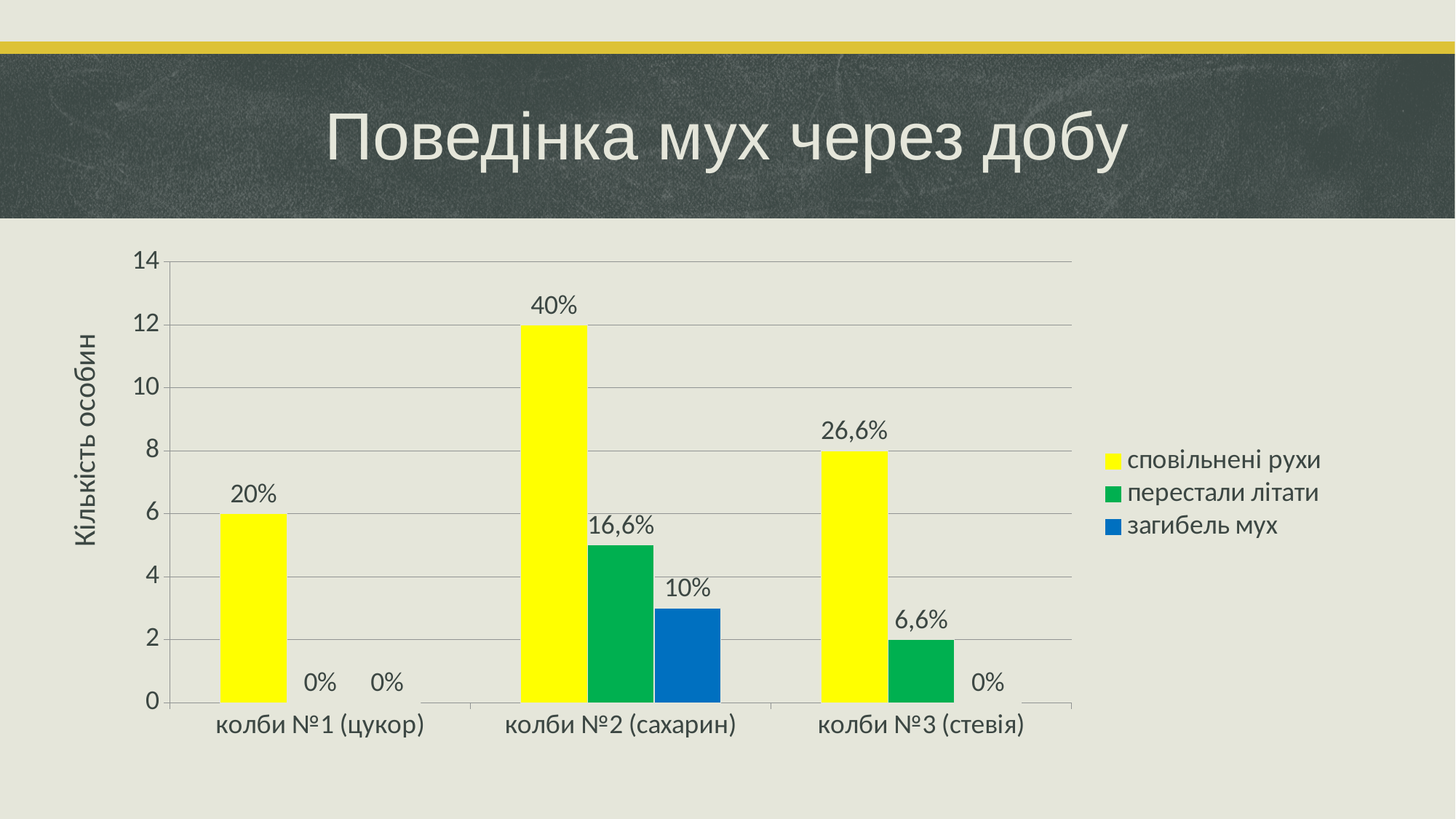
Which series has the lowest value in колби №2 (сахарин)? загибель мух What is the data label for перестали літати in колби №3 (стевія)? 6,6% How many categories (flasks) are shown on the x axis? 3 Which is larger for сповільнені рухи: колби №1 (цукор) or колби №3 (стевія)? колби №3 (стевія) How many series does the legend list? 3 Is the value for перестали літати in колби №2 (сахарин) greater or less than 4? greater What is the title of the y axis? Кількість особин What is the data label for загибель мух in колби №2 (сахарин)? 10% What kind of chart is shown on the slide? bar chart Which flask has the highest value for сповільнені рухи? колби №2 (сахарин) What is the data label for сповільнені рухи in колби №2 (сахарин)? 40% What is the difference between the сповільнені рухи labels for колби №2 (сахарин) and колби №1 (цукор)? 20%